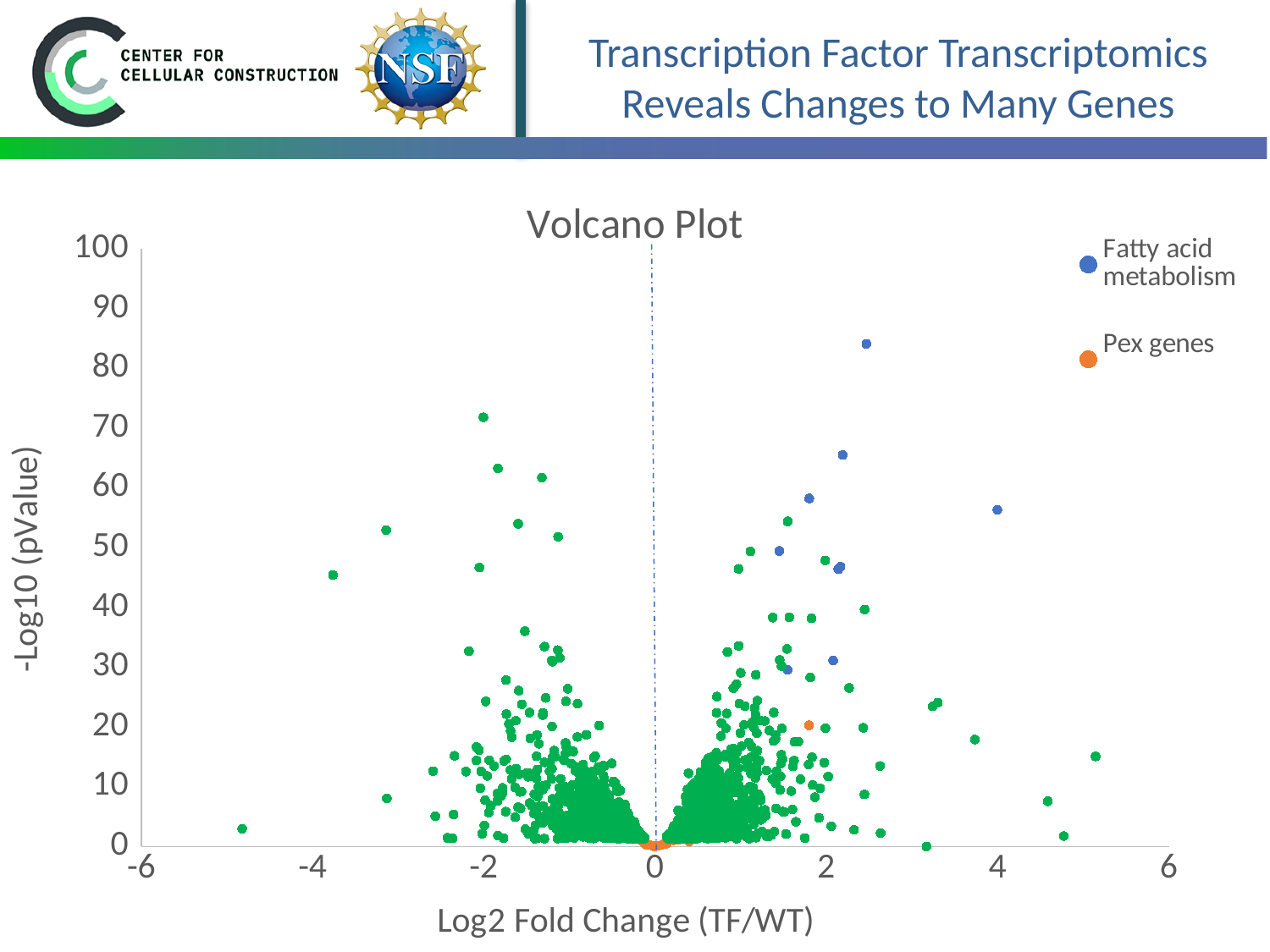
What is the maximum value shown on the y axis? 100 Which legend series is shown in orange? Pex genes What kind of chart is shown on the slide? scatter plot What is the title of the chart? Volcano Plot Is the highest Fatty acid metabolism point greater or less than 80 on the y axis? greater How many series does the chart's legend list? 2 Which legend series contains the point with the highest -Log10 (pValue)? Fatty acid metabolism Are the Pex genes points near a Log2 Fold Change of 0 greater or less than 10 on the y axis? less Is the Fatty acid metabolism point at a Log2 Fold Change of about 4 greater or less than 50 on the y axis? greater Are the Fatty acid metabolism points located at positive or negative Log2 Fold Change values? positive